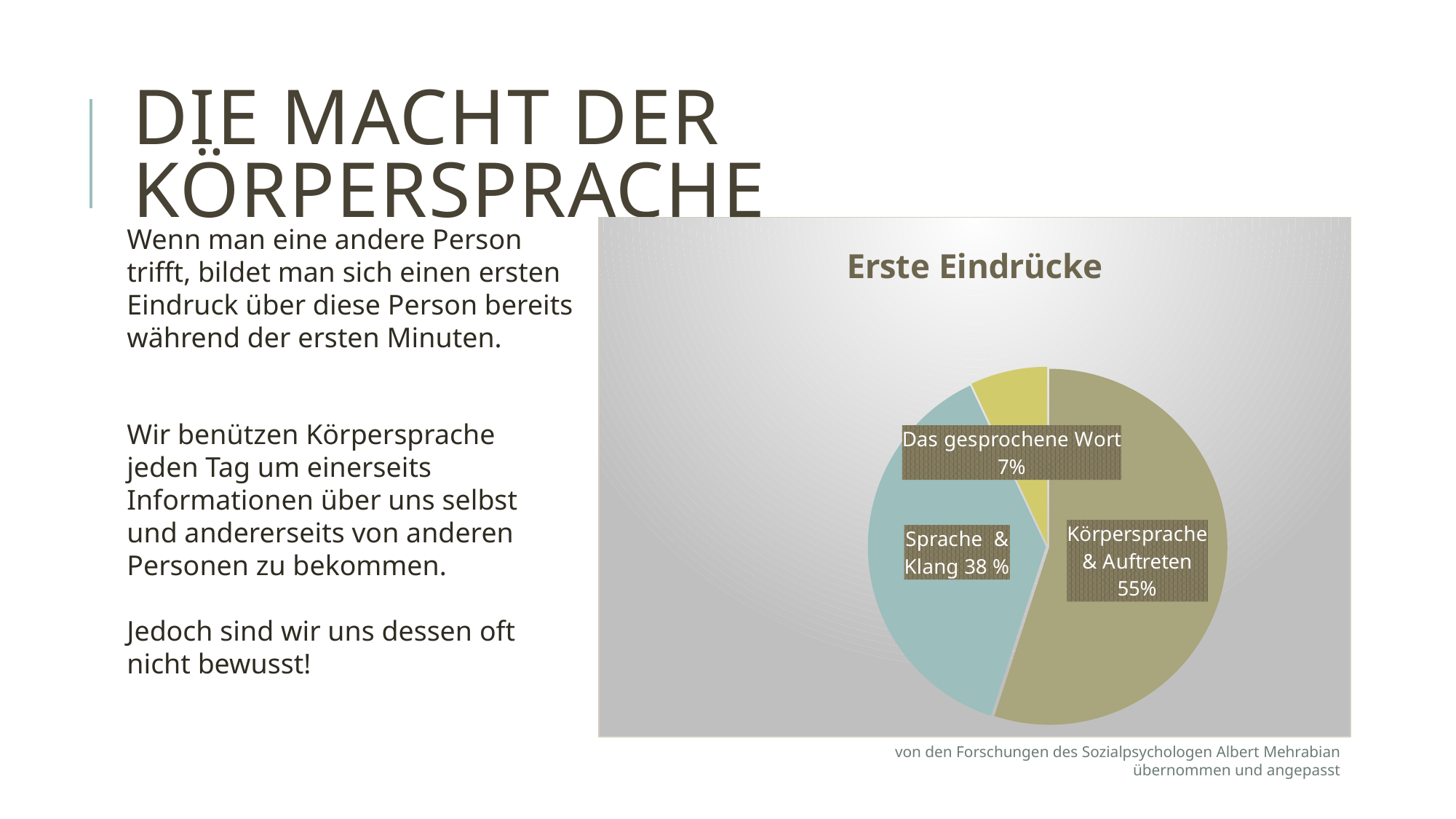
Which slice of the pie is the largest? Körpersprache & Auftreten How many slices does the pie chart have? 3 What share of the pie does "Das gesprochene Wort" have? 7% What is the difference in percentage points between "Körpersprache & Auftreten" and "Sprache & Klang"? 17 What is the difference in percentage points between "Sprache & Klang" and "Das gesprochene Wort"? 31 Which is larger, the share for "Sprache & Klang" or the share for "Das gesprochene Wort"? Sprache & Klang What share of the pie does "Körpersprache & Auftreten" have? 55% What share of the pie does "Sprache & Klang" have? 38 % Which slice of the pie is the smallest? Das gesprochene Wort What colour is the "Das gesprochene Wort" slice? yellow What is the title of the chart? Erste Eindrücke What kind of chart is shown on the slide? pie chart